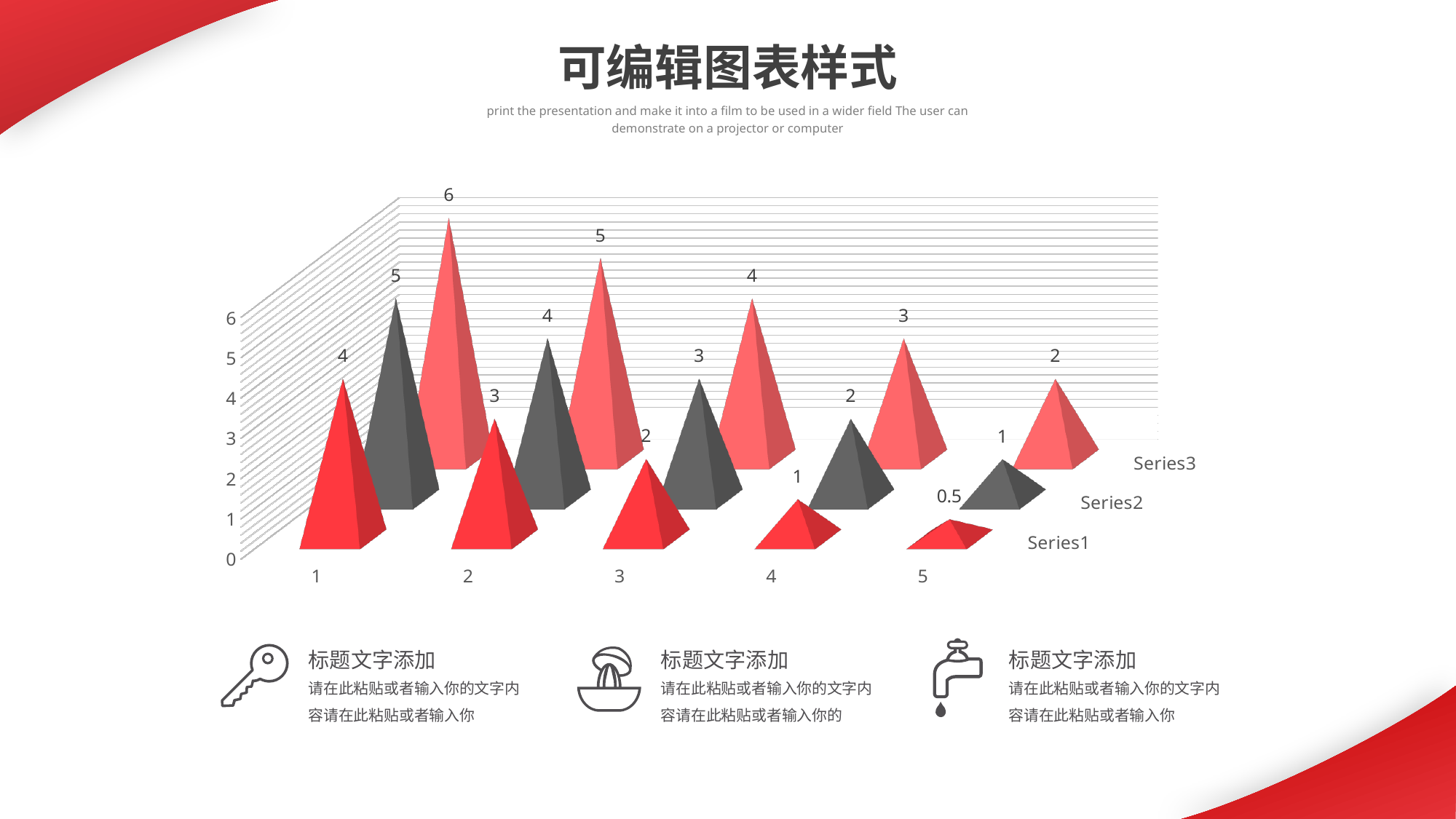
What is the value of Series1 at category 1? 4 Which is larger at category 4: Series2 or Series3? Series3 What is the value of Series1 at category 5? 0.5 Do the values of Series1 rise or fall from category 1 to category 5? fall What is the value of Series3 at category 1? 6 What is the total of Series1, Series2 and Series3 at category 3? 9 Which category has the lowest value for Series2? 5 Which category has the highest value for Series3? 1 What is the difference between Series3 and Series1 at category 2? 2 How many categories are shown on the x axis? 5 What is the value of Series2 at category 3? 3 How many series does the chart show? 3